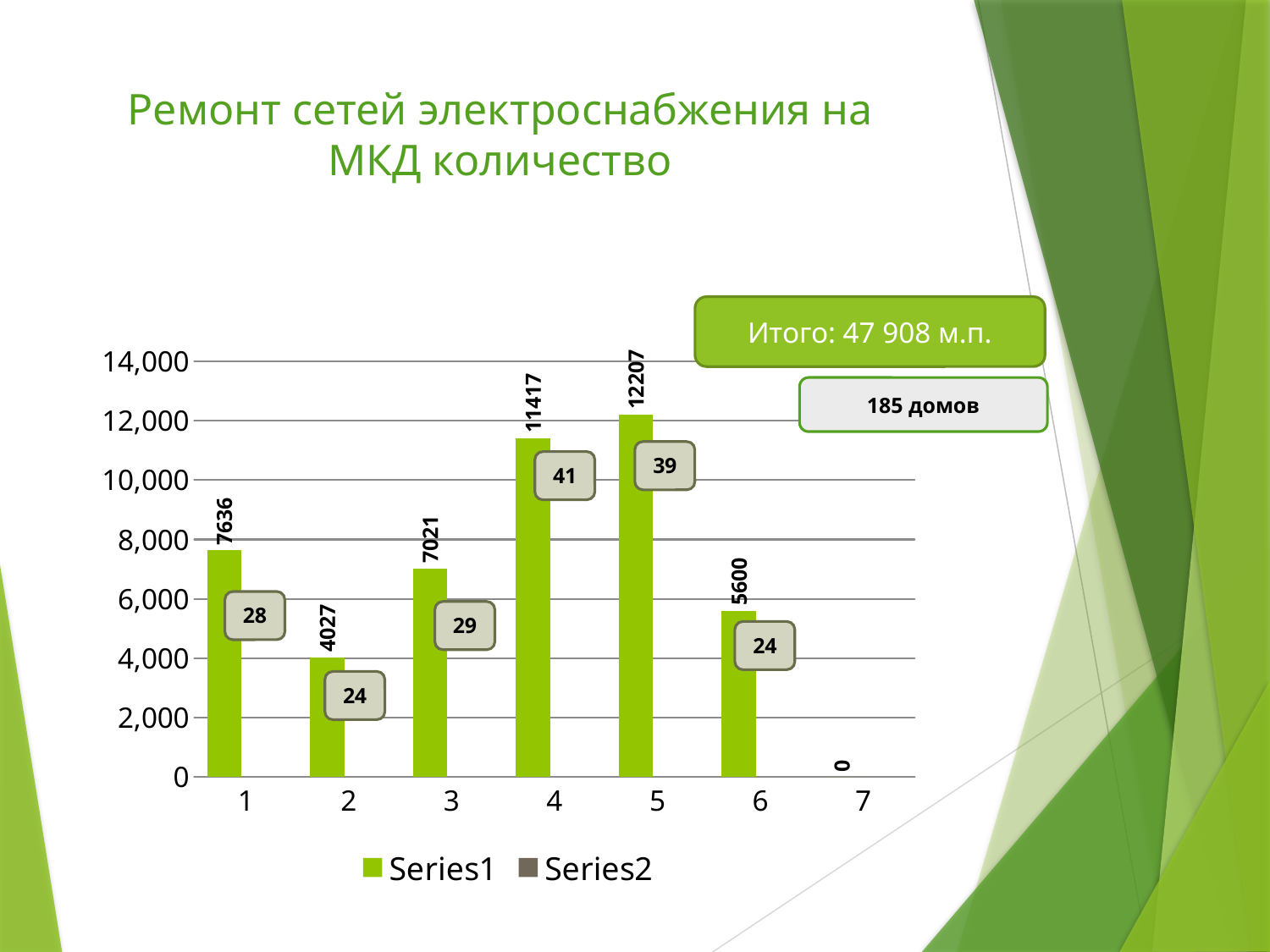
What kind of chart is shown on the slide? Bar chart Is the Series1 value for category 6 greater or less than 6,000? less How many series does the legend list? 2 What is the difference between the Series1 values for category 5 and category 4? 790 Among categories 1 to 6, which has the lowest Series1 value? 2 Which is larger, the Series1 value for category 1 or for category 3? Category 1 What is the Series1 value for category 7? 0 Which category has the highest Series1 value? 5 What is the Series1 value for category 2? 4027 What is the Series1 value for category 5? 12207 What total is shown in the green callout box on the slide? Итого: 47 908 м.п. How many categories are shown on the x axis? 7